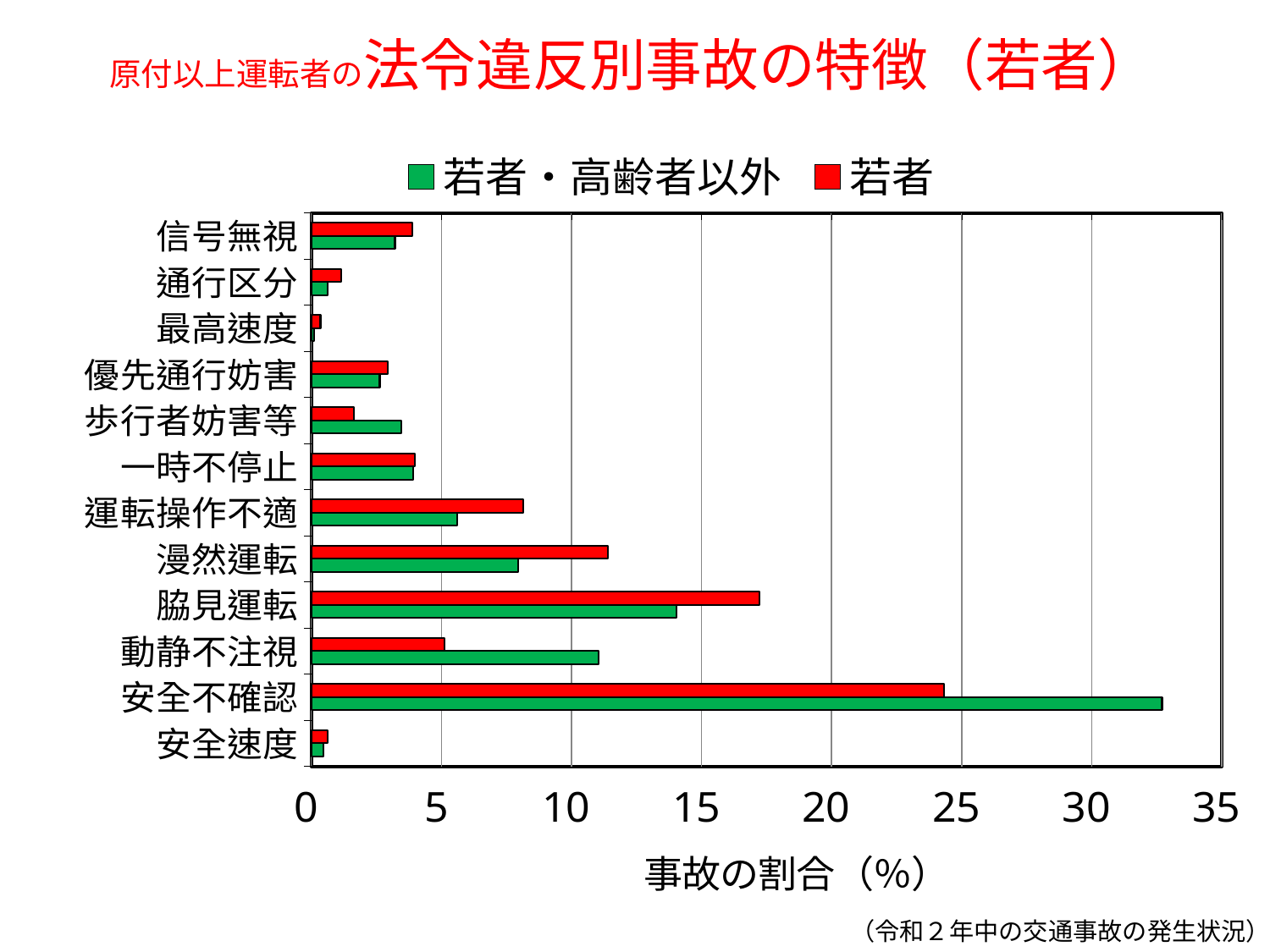
What kind of chart is shown on the slide? bar chart Is the 若者 value for 脇見運転 greater or less than 15? greater Which category has the highest value for the 若者・高齢者以外 series? 安全不確認 For 動静不注視, which series has the larger value, 若者 or 若者・高齢者以外? 若者・高齢者以外 Is the 若者・高齢者以外 value for 安全不確認 greater or less than 30? greater How many violation categories are plotted on the y axis? 12 Which category has the lowest value for the 若者・高齢者以外 series? 最高速度 What colour represents the 若者 series in the chart? red How many series does the legend list? 2 For 脇見運転, which series has the larger value, 若者 or 若者・高齢者以外? 若者 Which category has the highest value for the 若者 series? 安全不確認 For 安全不確認, which series has the larger value, 若者 or 若者・高齢者以外? 若者・高齢者以外